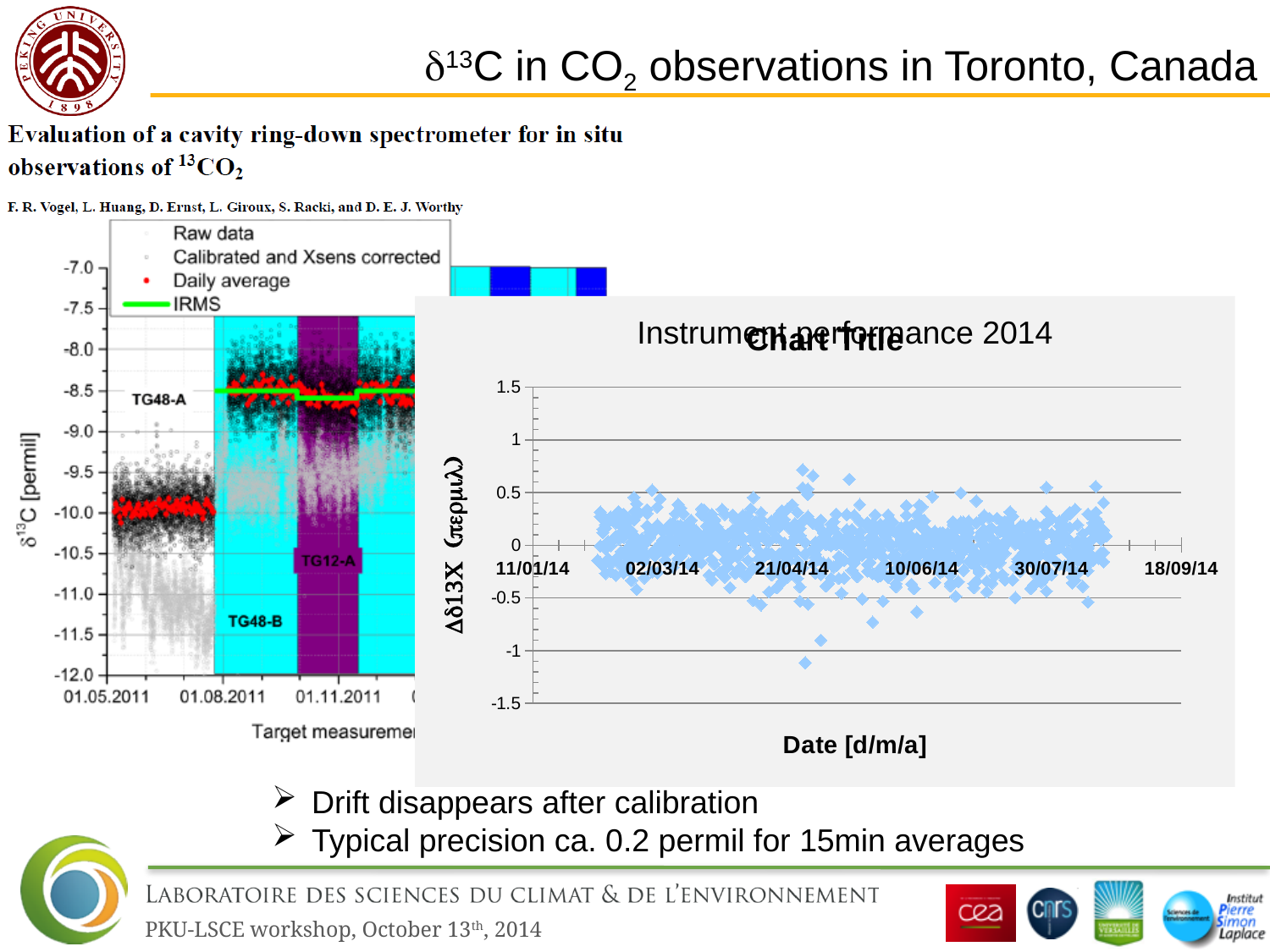
On the left chart (δ13C target measurements), is the daily average before 01.08.2011 greater or less than -9.5? less On the left chart (δ13C target measurements), how many entries does the legend list? 4 On the left chart (δ13C target measurements), what is the first date label on the x axis? 01.05.2011 On the 'Instrument performance 2014' chart, do the plotted values rise, fall, or stay roughly flat from 02/03/14 to 30/07/14? roughly flat On the 'Instrument performance 2014' chart, is the highest plotted point greater or less than 0.5? greater On the 'Instrument performance 2014' chart, what is the highest value shown on the y axis? 1.5 On the 'Instrument performance 2014' chart, how many date labels are shown along the x axis? 6 On the 'Instrument performance 2014' chart, what is the x-axis title? Date [d/m/a] What kind of chart is the 'Instrument performance 2014' chart on the right of the slide? scatter chart On the 'Instrument performance 2014' chart, what is the lowest value shown on the y axis? -1.5 On the 'Instrument performance 2014' chart, is the lowest plotted point greater or less than -0.5? less